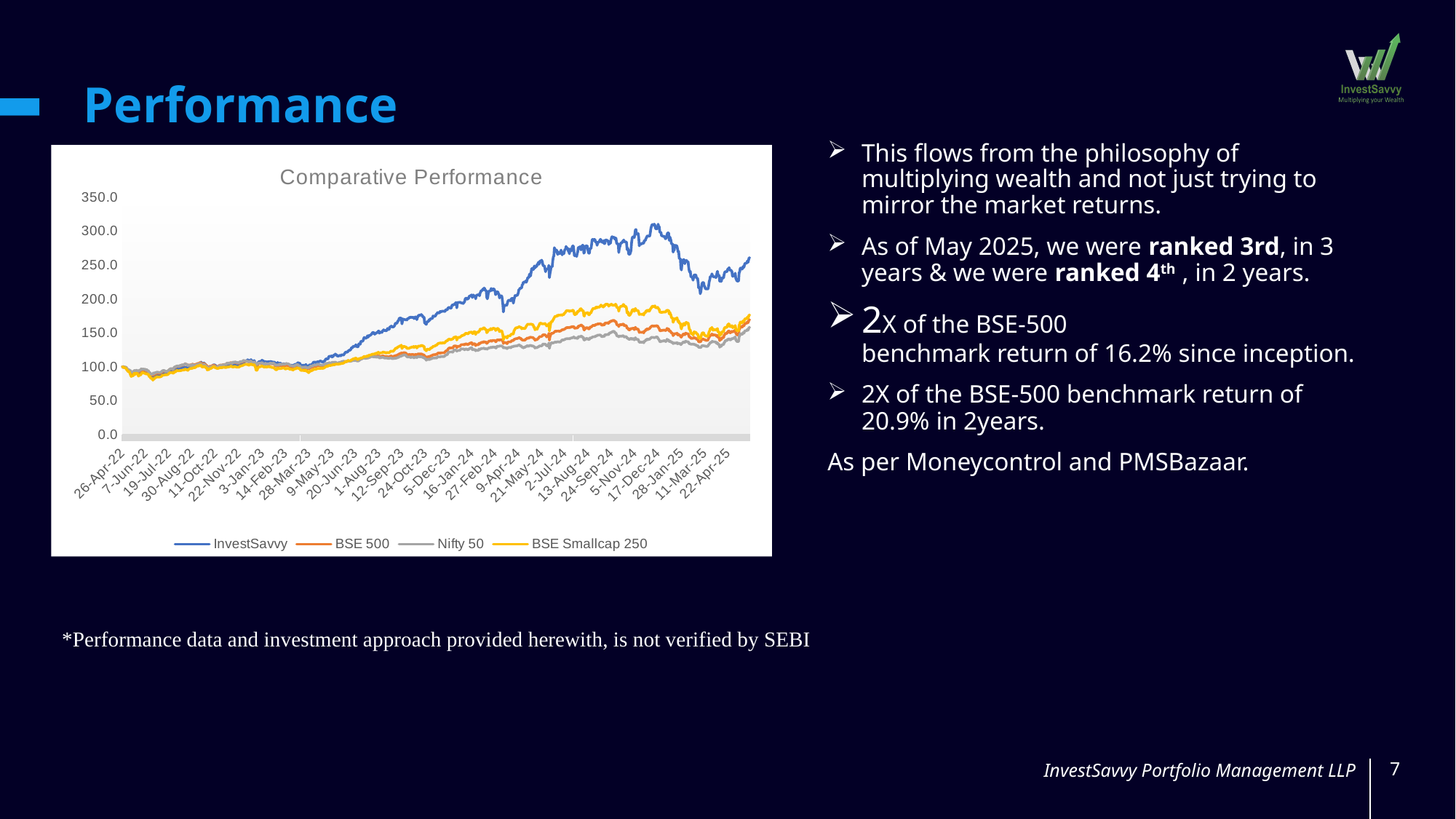
Is the value for BSE Smallcap 250 at the end of the chart greater or less than 250? less How many series does the legend of the chart list? 4 Is the value for Nifty 50 at the end of the chart greater or less than 200? less Does the InvestSavvy line rise or fall overall from the start to the end of the chart? Rise Is the peak value for InvestSavvy greater or less than 250? greater What is the title of the chart? Comparative Performance Which series in the chart is drawn in blue? InvestSavvy Which series has the highest value at the end of the chart (22-Apr-25)? InvestSavvy What kind of chart is shown on the slide? Line chart At the end of the chart, which is larger: InvestSavvy or Nifty 50? InvestSavvy What is the highest value shown on the y axis of the chart? 350.0